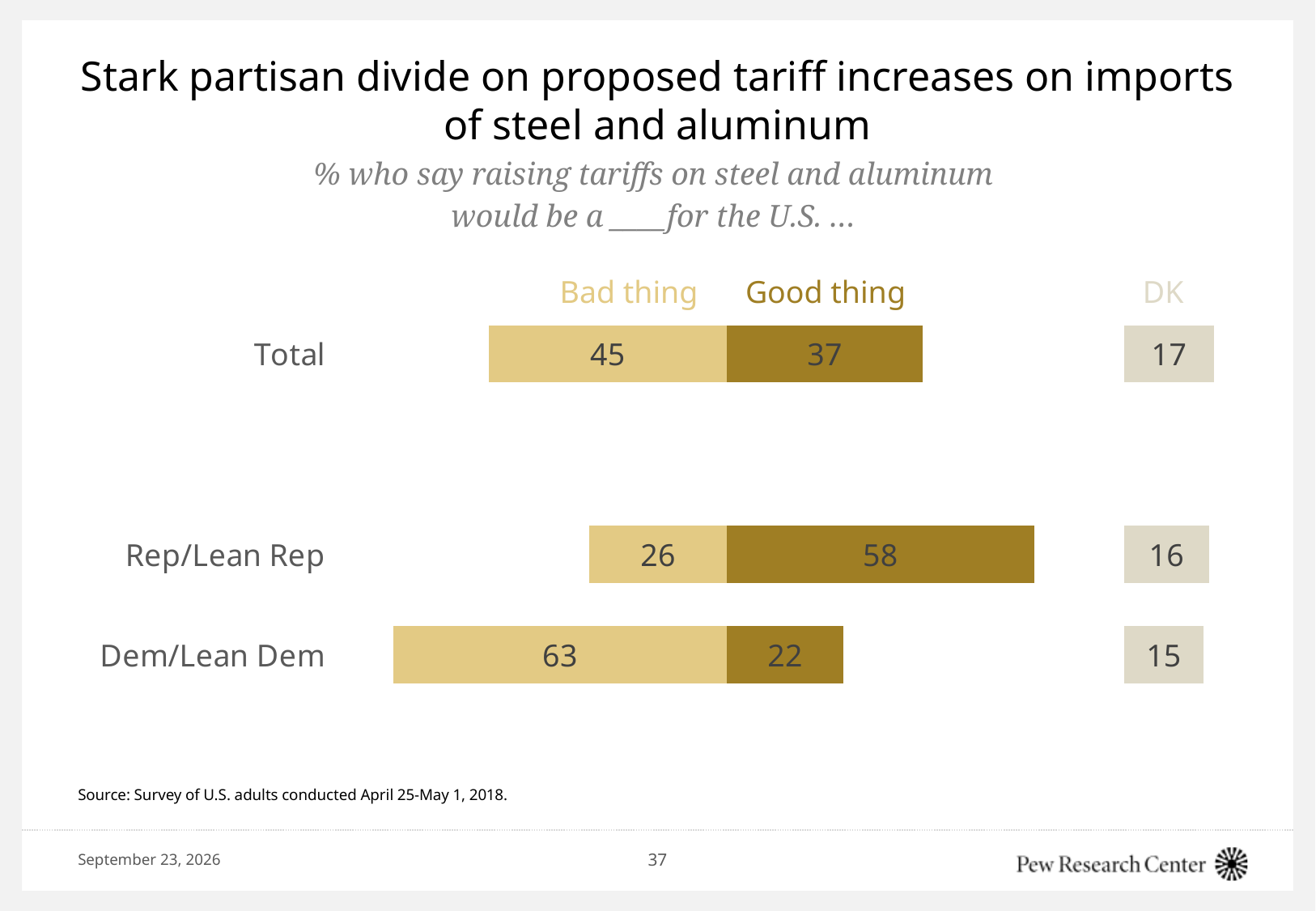
What percentage of Rep/Lean Rep say raising tariffs on steel and aluminum would be a good thing? 58 What percentage of Dem/Lean Dem say raising tariffs would be a bad thing? 63 What percentage of Total say raising tariffs would be a good thing? 37 Which group has the lowest 'Good thing' value? Dem/Lean Dem What is the combined 'Bad thing' and 'Good thing' total for Rep/Lean Rep? 84 What is the DK value for Total? 17 Which group has the highest 'Bad thing' value? Dem/Lean Dem How many response categories does the chart show? 3 What kind of chart is shown on the slide? Bar chart How many groups are shown in the chart? 3 Which is larger for Total: the 'Bad thing' value or the 'Good thing' value? Bad thing What is the difference between the 'Good thing' values for Rep/Lean Rep and Dem/Lean Dem? 36